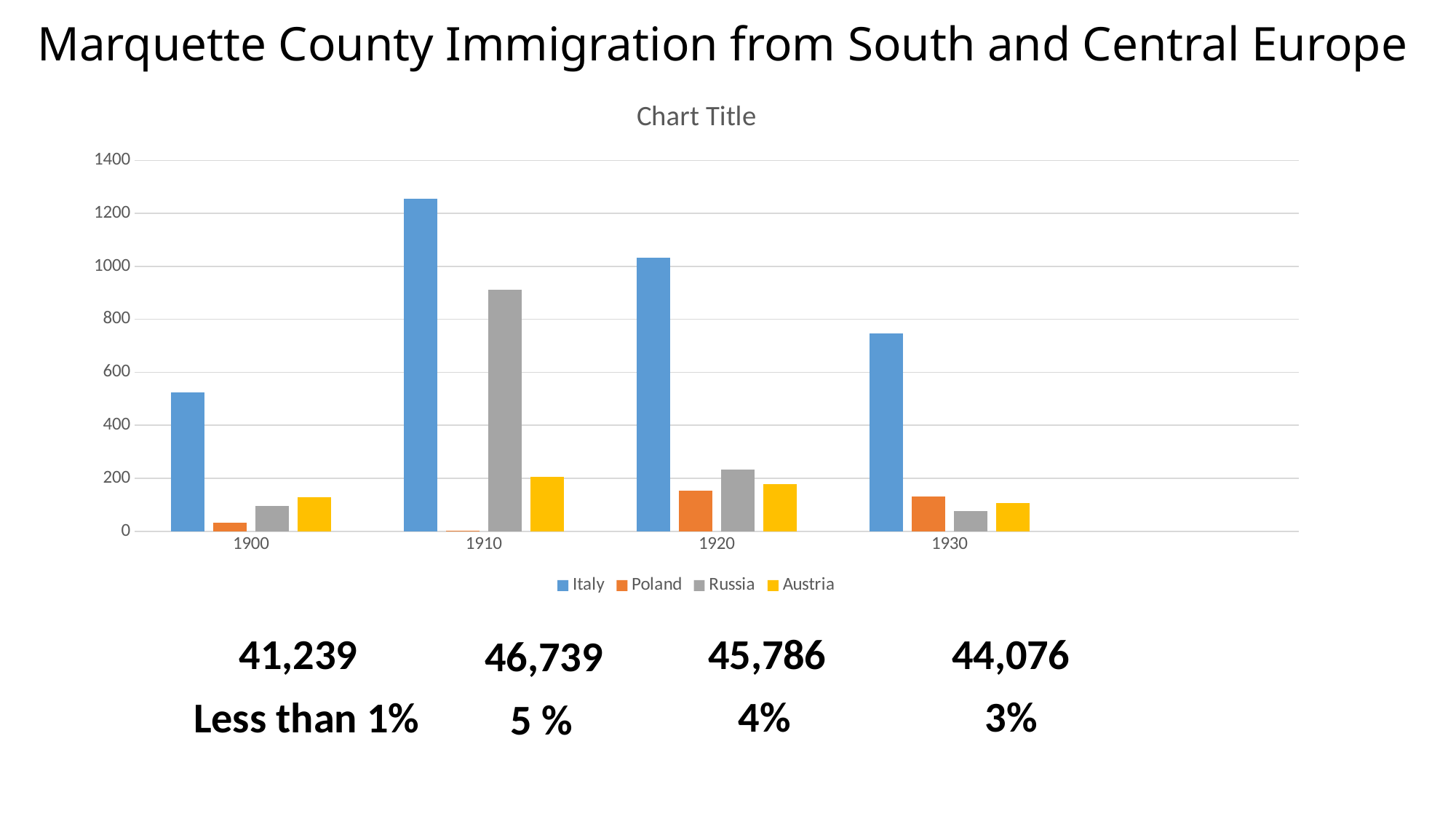
Is the value for Russia in 1910 greater or less than 800? greater Is the value for Italy in 1930 greater or less than 600? greater In which year is the Italy bar the highest? 1910 How many years are shown on the x axis? 4 Which series has the lowest bar in 1910? Poland How many series does the legend list? 4 What kind of chart is shown on the slide? bar chart Is the value for Italy in 1910 greater or less than 1200? greater Does the value for Italy rise or fall from 1910 to 1930? fall Which series is shown in yellow in the legend? Austria In 1900, which is larger, the value for Italy or the value for Austria? Italy In 1930, which is larger, the value for Poland or the value for Russia? Poland